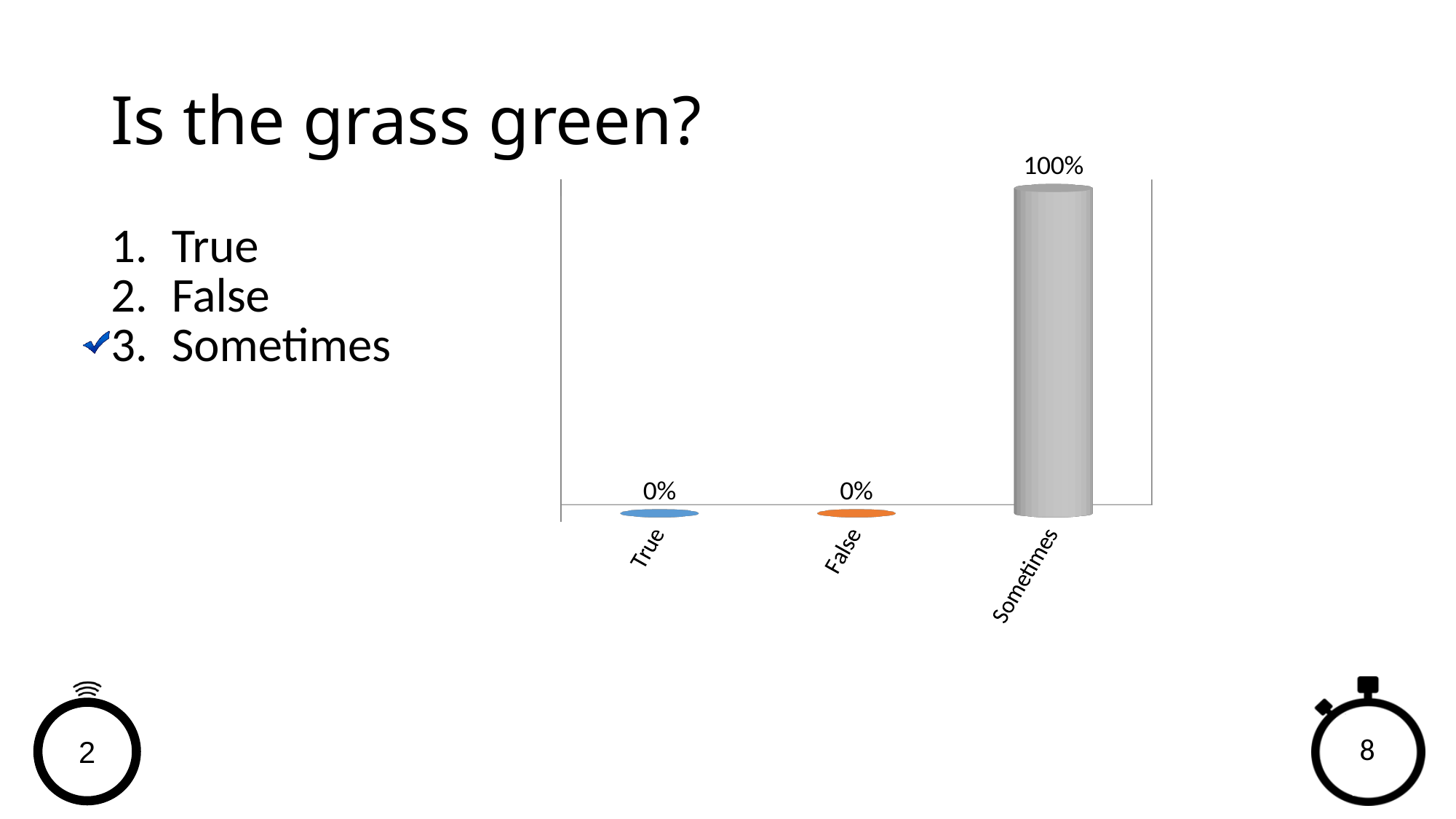
What is the value for True? 0% What is the title of the slide containing the chart? Is the grass green? Which is larger, the value for Sometimes or the value for False? Sometimes What colour is the bar for Sometimes? grey Which category has the highest value? Sometimes What is the value for False? 0% What is the value for Sometimes? 100% What is the total of the values for True, False and Sometimes? 100% How many categories are shown on the chart? 3 What is the difference between the values for Sometimes and True? 100% What kind of chart is shown on the slide? bar chart